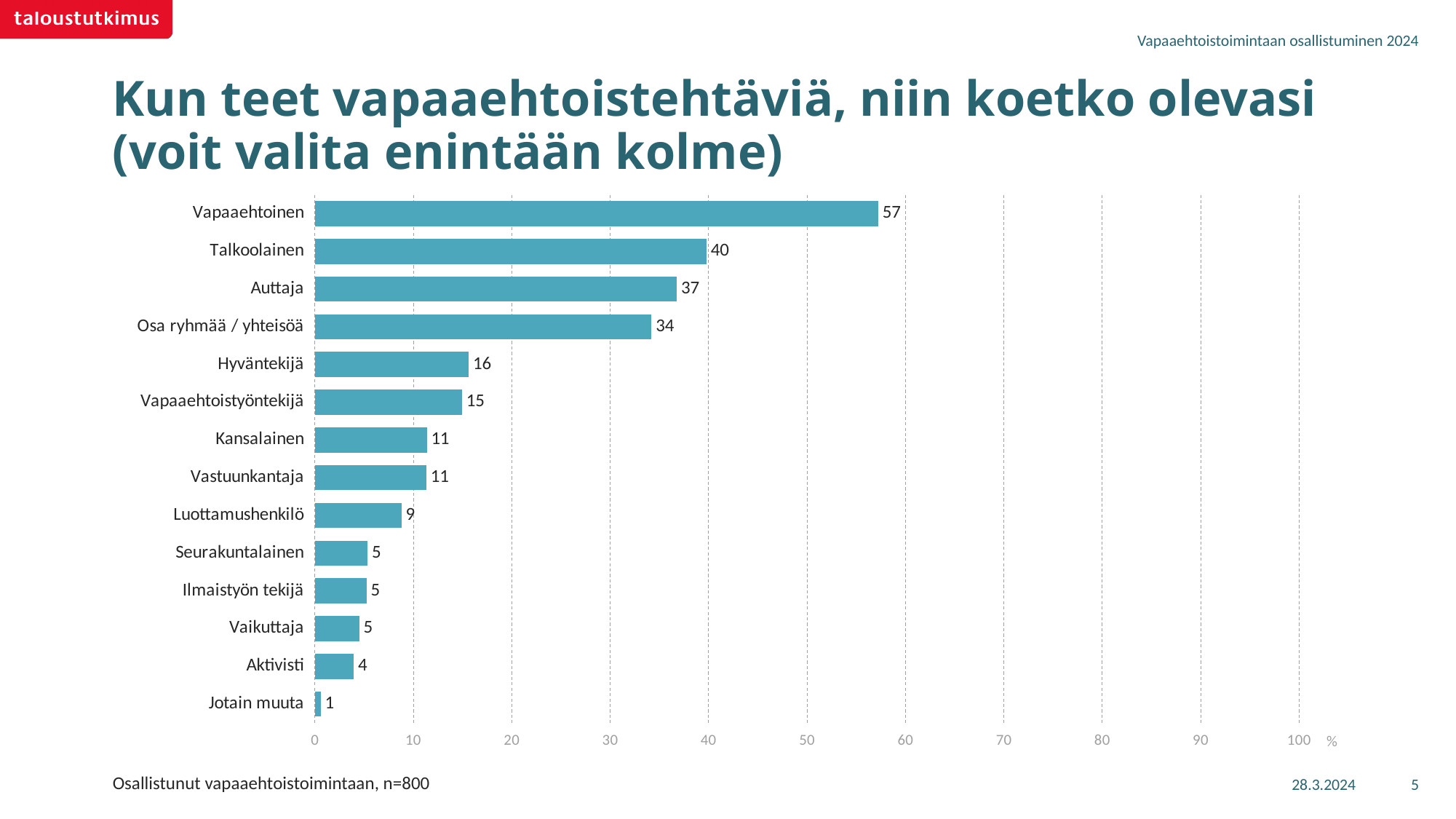
What is the value for Luottamushenkilö? 9 Which is larger, the value for Hyväntekijä or the value for Kansalainen? Hyväntekijä What is the value for Vapaaehtoinen? 57 Which category has the highest value? Vapaaehtoinen Is the value for Talkoolainen greater or less than 30? greater What unit is shown at the end of the horizontal axis? % What is the value for Osa ryhmää / yhteisöä? 34 How many categories are shown in the chart? 14 What is the difference between the values for Talkoolainen and Auttaja? 3 What kind of chart is shown on the slide? bar chart What is the difference between the values for Vapaaehtoinen and Hyväntekijä? 41 Which category has the lowest value? Jotain muuta